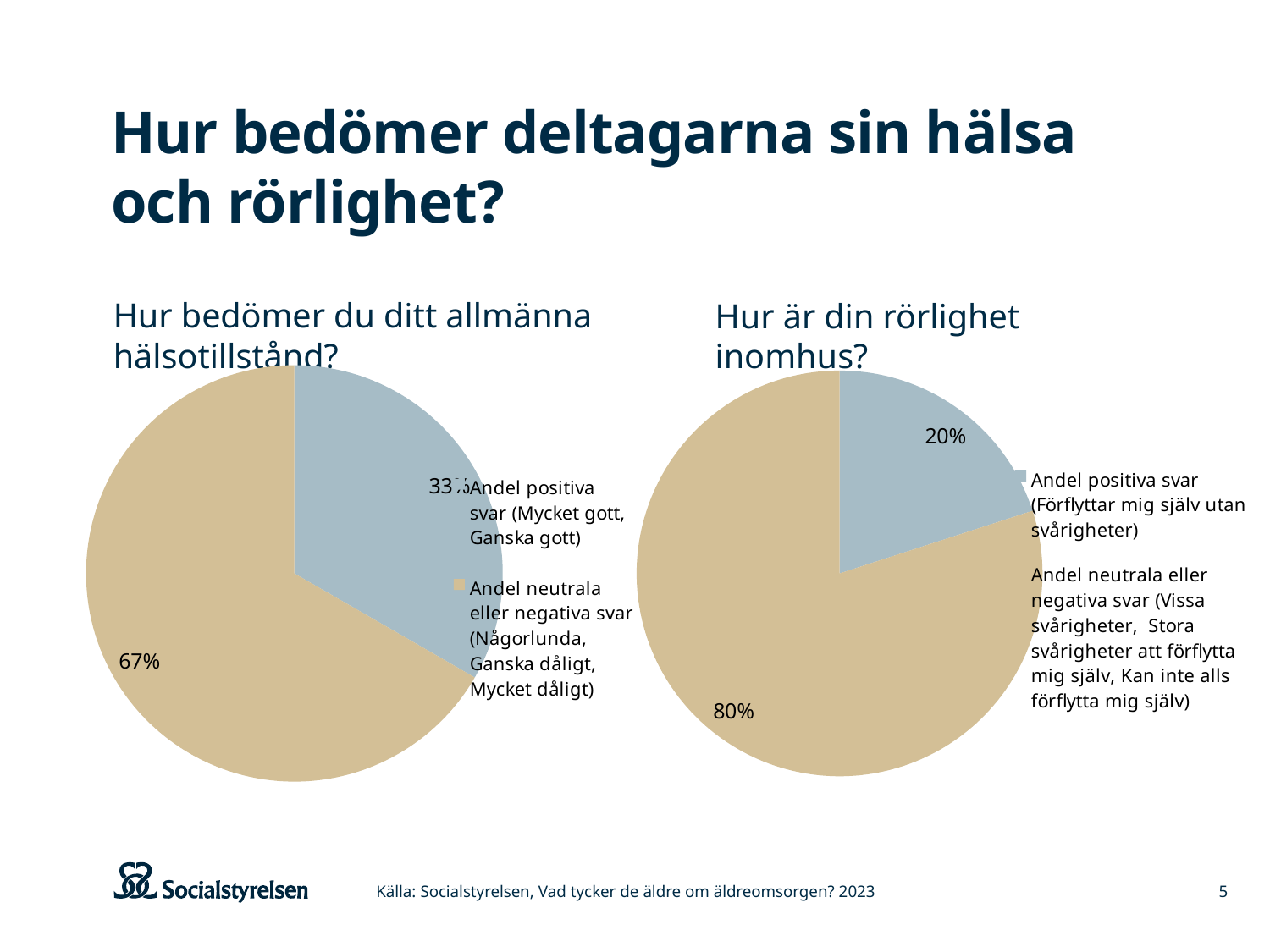
In the chart titled "Hur är din rörlighet inomhus?", which slice is larger: positive responses or neutral/negative responses? Neutral/negative responses How many categories does the legend of the chart "Hur bedömer du ditt allmänna hälsotillstånd?" list? 2 In the chart titled "Hur är din rörlighet inomhus?", what colour is the slice for positive responses? Blue What kind of chart is used for "Hur är din rörlighet inomhus?"? Pie chart In the chart titled "Hur bedömer du ditt allmänna hälsotillstånd?", which category has the largest slice? Andel neutrala eller negativa svar How many slices does the pie chart "Hur är din rörlighet inomhus?" have? 2 In the chart titled "Hur bedömer du ditt allmänna hälsotillstånd?", what share of responses are neutral or negative? 67% In the chart titled "Hur är din rörlighet inomhus?", which category has the smallest slice? Andel positiva svar In the chart titled "Hur är din rörlighet inomhus?", what share of responses are neutral or negative? 80% In the chart titled "Hur är din rörlighet inomhus?", what is the difference between the neutral/negative share and the positive share? 60 percentage points What kind of chart is used for "Hur bedömer du ditt allmänna hälsotillstånd?"? Pie chart In the chart titled "Hur är din rörlighet inomhus?", what share of responses are positive (Förflyttar mig själv utan svårigheter)? 20%